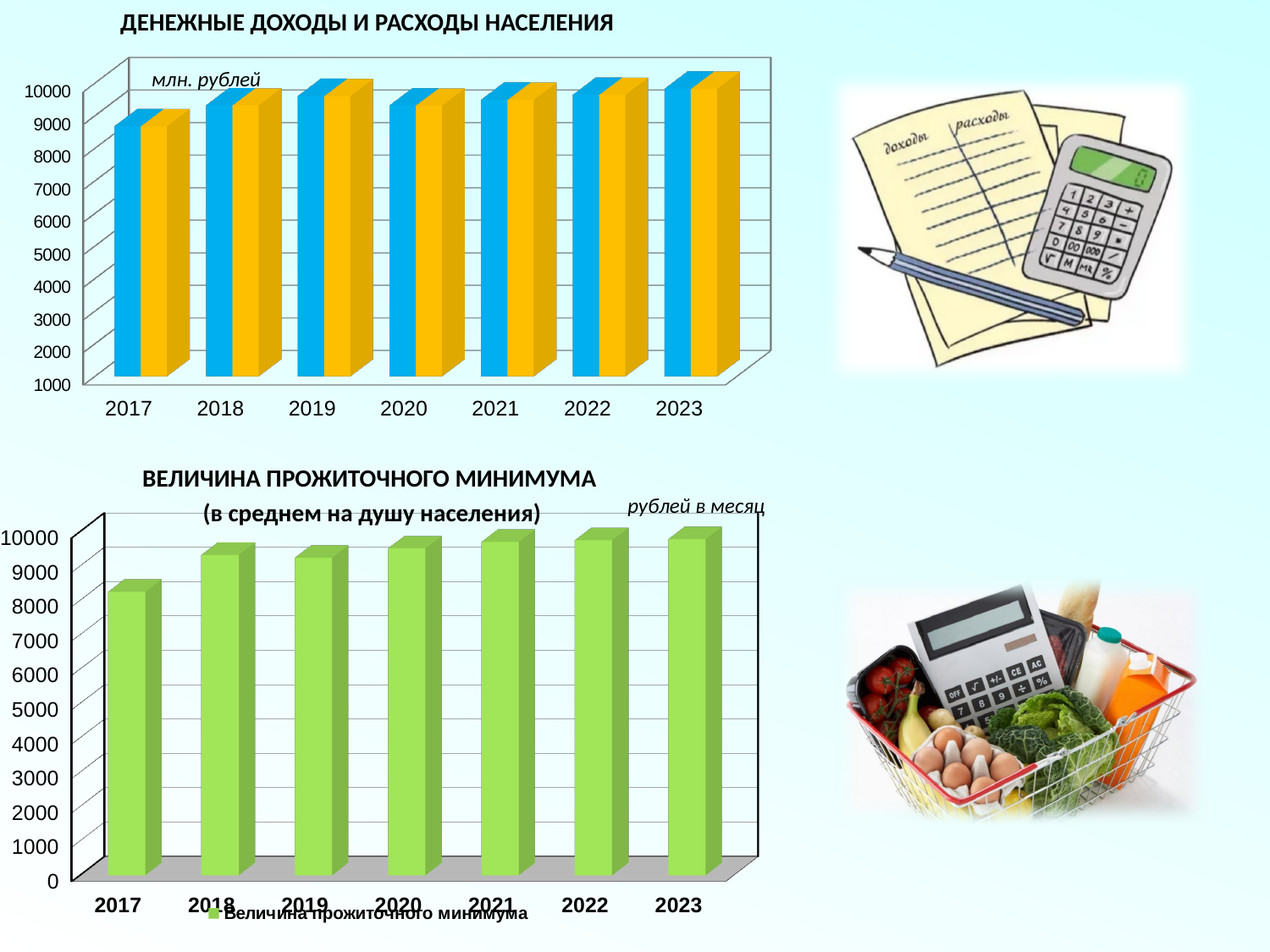
In the bottom chart 'ВЕЛИЧИНА ПРОЖИТОЧНОГО МИНИМУМА', is the value for 2023 greater or less than 9000? greater In the bottom chart 'ВЕЛИЧИНА ПРОЖИТОЧНОГО МИНИМУМА', which year has the lowest value? 2017 In the top chart 'ДЕНЕЖНЫЕ ДОХОДЫ И РАСХОДЫ НАСЕЛЕНИЯ', how many years are shown on the x axis? 7 In the top chart 'ДЕНЕЖНЫЕ ДОХОДЫ И РАСХОДЫ НАСЕЛЕНИЯ', is the blue bar for 2017 greater or less than 8000? greater In the top chart 'ДЕНЕЖНЫЕ ДОХОДЫ И РАСХОДЫ НАСЕЛЕНИЯ', is the blue bar for 2019 greater or less than 9000? greater What kind of chart is the top chart titled 'ДЕНЕЖНЫЕ ДОХОДЫ И РАСХОДЫ НАСЕЛЕНИЯ'? Bar chart In the top chart 'ДЕНЕЖНЫЕ ДОХОДЫ И РАСХОДЫ НАСЕЛЕНИЯ', what unit is written above the chart area? млн. рублей In the bottom chart 'ВЕЛИЧИНА ПРОЖИТОЧНОГО МИНИМУМА', how many series does the legend list? 1 What kind of chart is the bottom chart titled 'ВЕЛИЧИНА ПРОЖИТОЧНОГО МИНИМУМА'? Bar chart In the bottom chart 'ВЕЛИЧИНА ПРОЖИТОЧНОГО МИНИМУМА', how many bars are there? 7 In the top chart 'ДЕНЕЖНЫЕ ДОХОДЫ И РАСХОДЫ НАСЕЛЕНИЯ', which year has the lowest bars? 2017